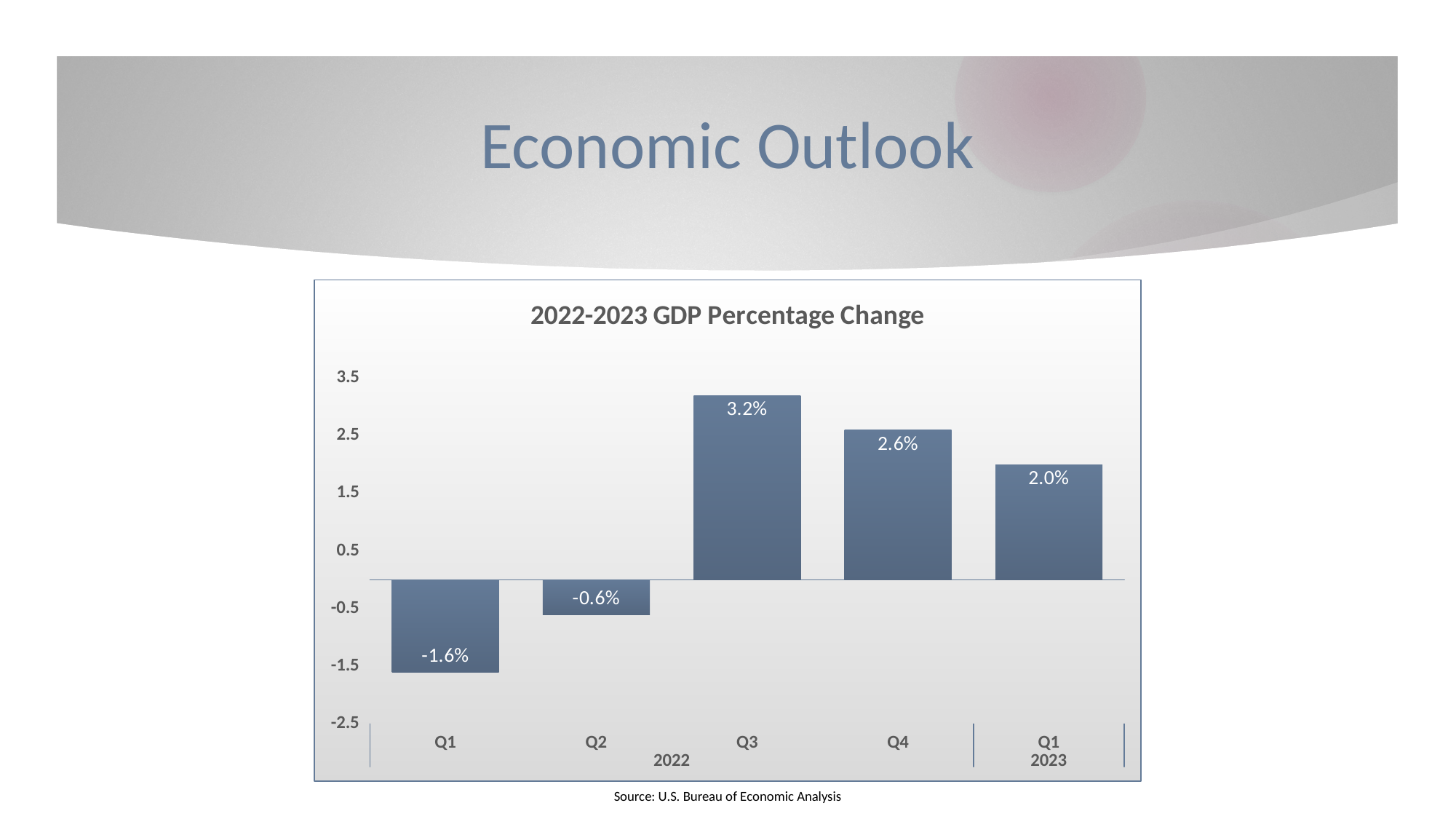
What is the source cited below the chart? U.S. Bureau of Economic Analysis What is the GDP percentage change for Q1 2023? 2.0% What is the difference between the GDP percentage change in Q3 2022 and Q4 2022? 0.6% How many quarters are shown in the chart? 5 What is the GDP percentage change for Q3 2022? 3.2% Is the value for Q2 2022 greater or less than 0.5? less Which quarter has the lowest GDP percentage change? Q1 2022 What is the title of the chart? 2022-2023 GDP Percentage Change Which is larger, the GDP percentage change for Q4 2022 or Q1 2023? Q4 2022 Which quarter has the highest GDP percentage change? Q3 2022 What kind of chart is shown on the slide? Bar chart What is the GDP percentage change for Q1 2022? -1.6%